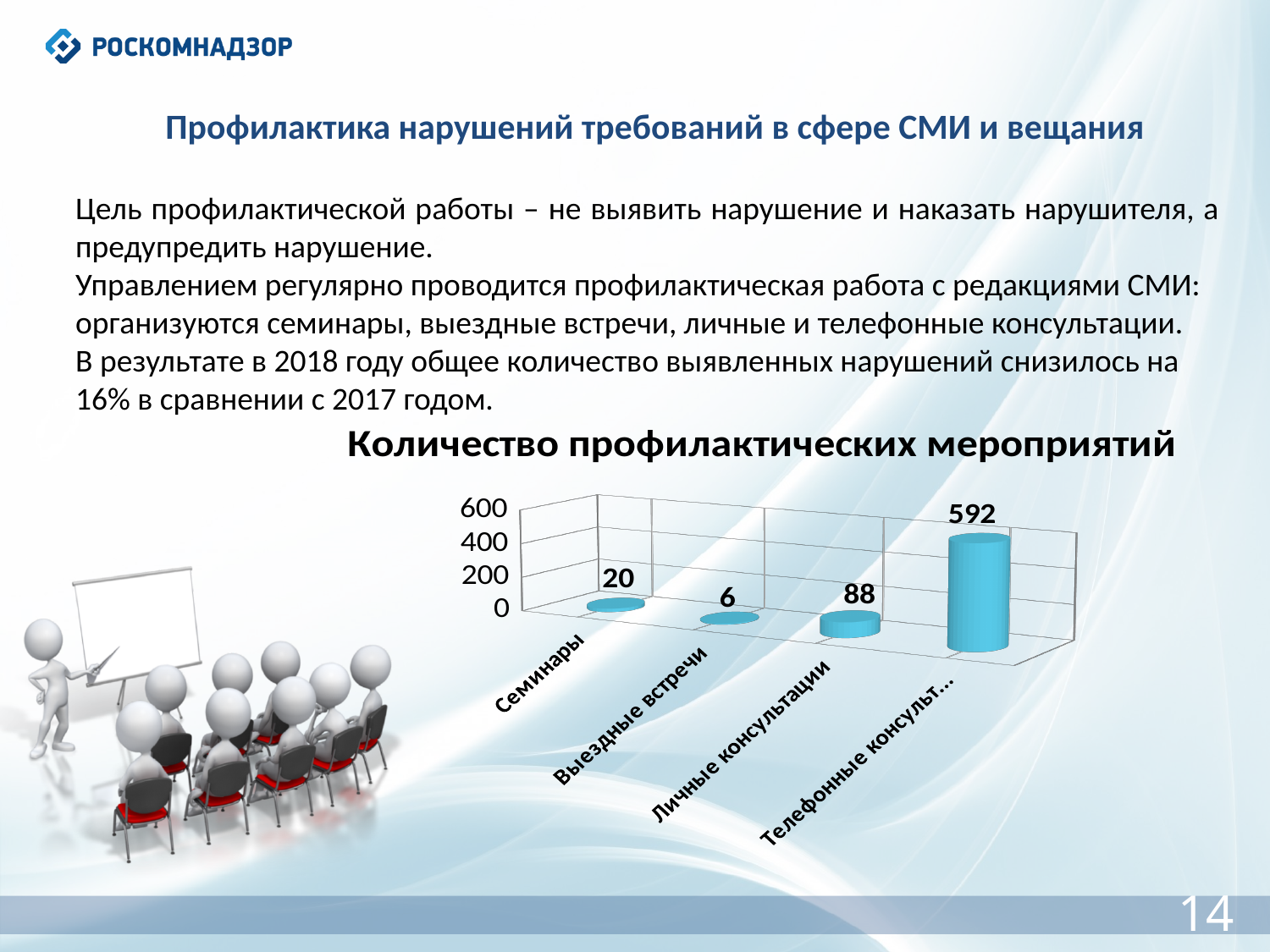
What kind of chart is shown on the slide? Bar chart What is the value for Выездные встречи? 6 Which category has the lowest value in the chart? Выездные встречи Which category has the highest value in the chart? Телефонные консульт… What is the title of the chart on the slide? Количество профилактических мероприятий What is the difference between the values for 'Телефонные консульт…' and Личные консультации? 504 How many categories are shown in the chart? 4 Which is larger, the value for Семинары or the value for Выездные встречи? Семинары What is the difference between the values for Личные консультации and Семинары? 68 What is the value for Личные консультации? 88 What is the value for Семинары in the chart 'Количество профилактических мероприятий'? 20 What is the value for the category labelled 'Телефонные консульт…'? 592